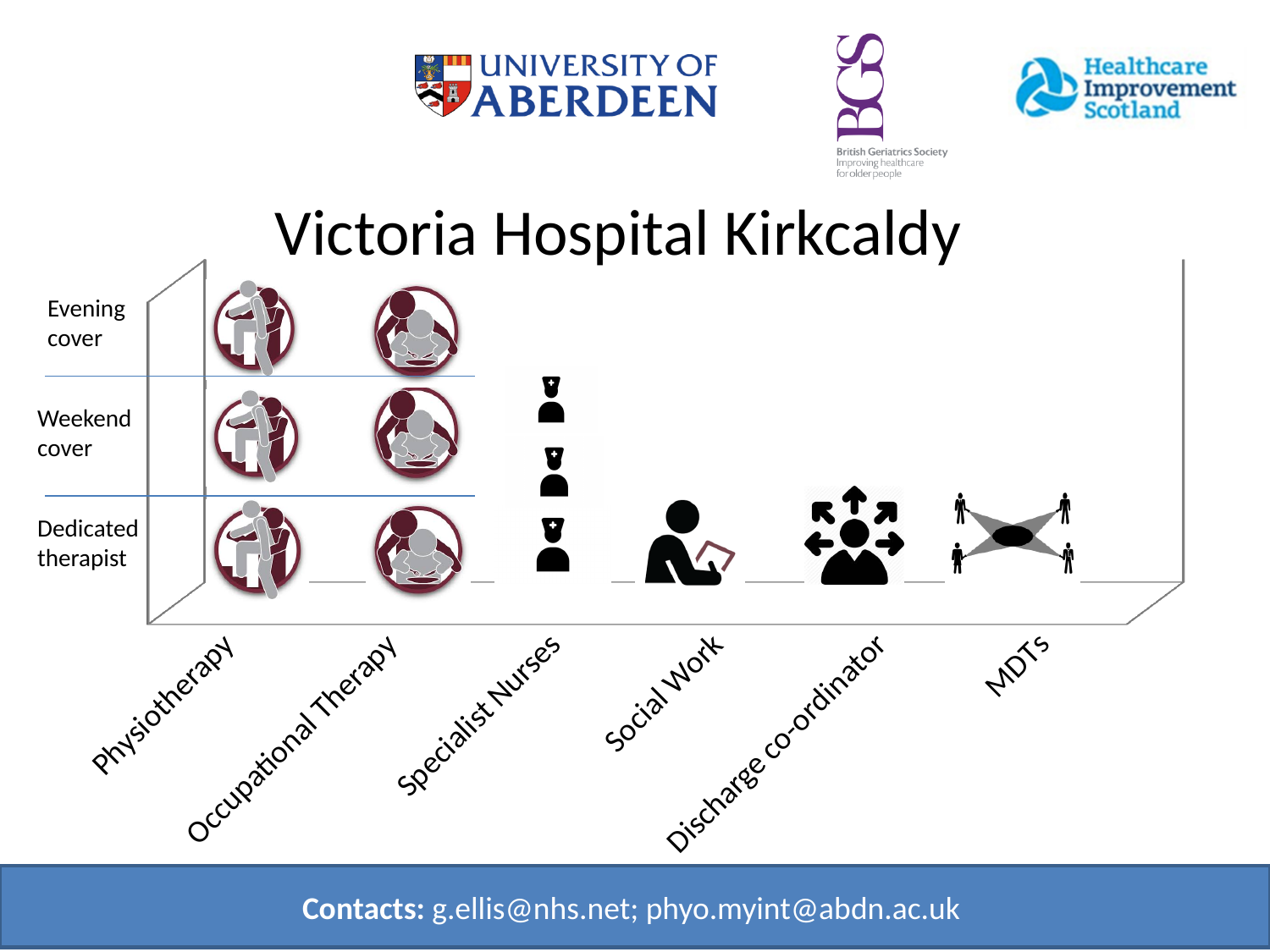
Up to which level does the 'Social Work' category reach in the chart? Dedicated therapist How many levels of cover are labelled on the vertical axis of the chart? 3 What is the difference in the number of stacked icons between 'Specialist Nurses' and 'Social Work' in the chart? 2 Which category is the last (rightmost) on the x axis of the chart? MDTs Which categories in the chart reach the 'Evening cover' level? Physiotherapy and Occupational Therapy Which has more icons stacked in the chart, 'Occupational Therapy' or 'Discharge co-ordinator'? Occupational Therapy How many service categories are shown along the x axis of the chart? 6 How many icons are stacked for 'MDTs' in the chart? 1 What kind of chart is shown on the slide? Pictogram (icon) chart Up to which level does the 'Specialist Nurses' category reach in the chart? Weekend cover How many icons are stacked for 'Physiotherapy' in the chart? 3 What is the title of the chart on the slide? Victoria Hospital Kirkcaldy